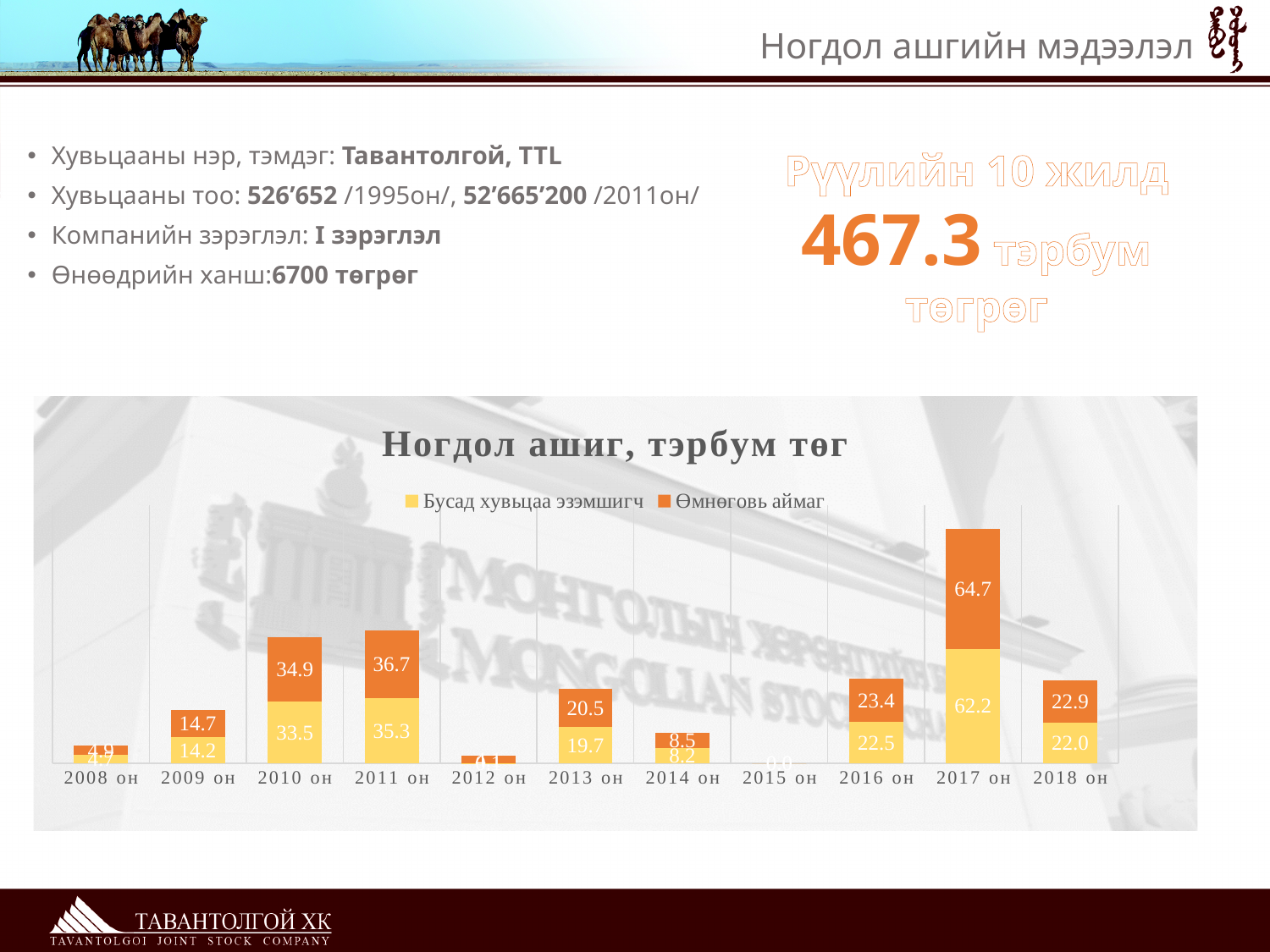
Which is larger, the Өмнөговь аймаг value in 2010 он or in 2011 он? 2011 он What type of chart is shown on the slide? bar chart How many series does the chart legend list? 2 Does the total dividend rise or fall from 2016 он to 2017 он? rise How many years are shown on the x axis of the chart? 11 What is the value for Бусад хувьцаа эзэмшигч in 2010 он? 33.5 Which year has the highest total dividend in the chart? 2017 он What is the difference between the Өмнөговь аймаг and Бусад хувьцаа эзэмшигч values in 2017 он? 2.5 What is the value for Өмнөговь аймаг in 2013 он? 20.5 What is the value for Өмнөговь аймаг in 2017 он? 64.7 What is the total of the stacked bar for 2010 он? 68.4 What is the title of the chart? Ногдол ашиг, тэрбум төг